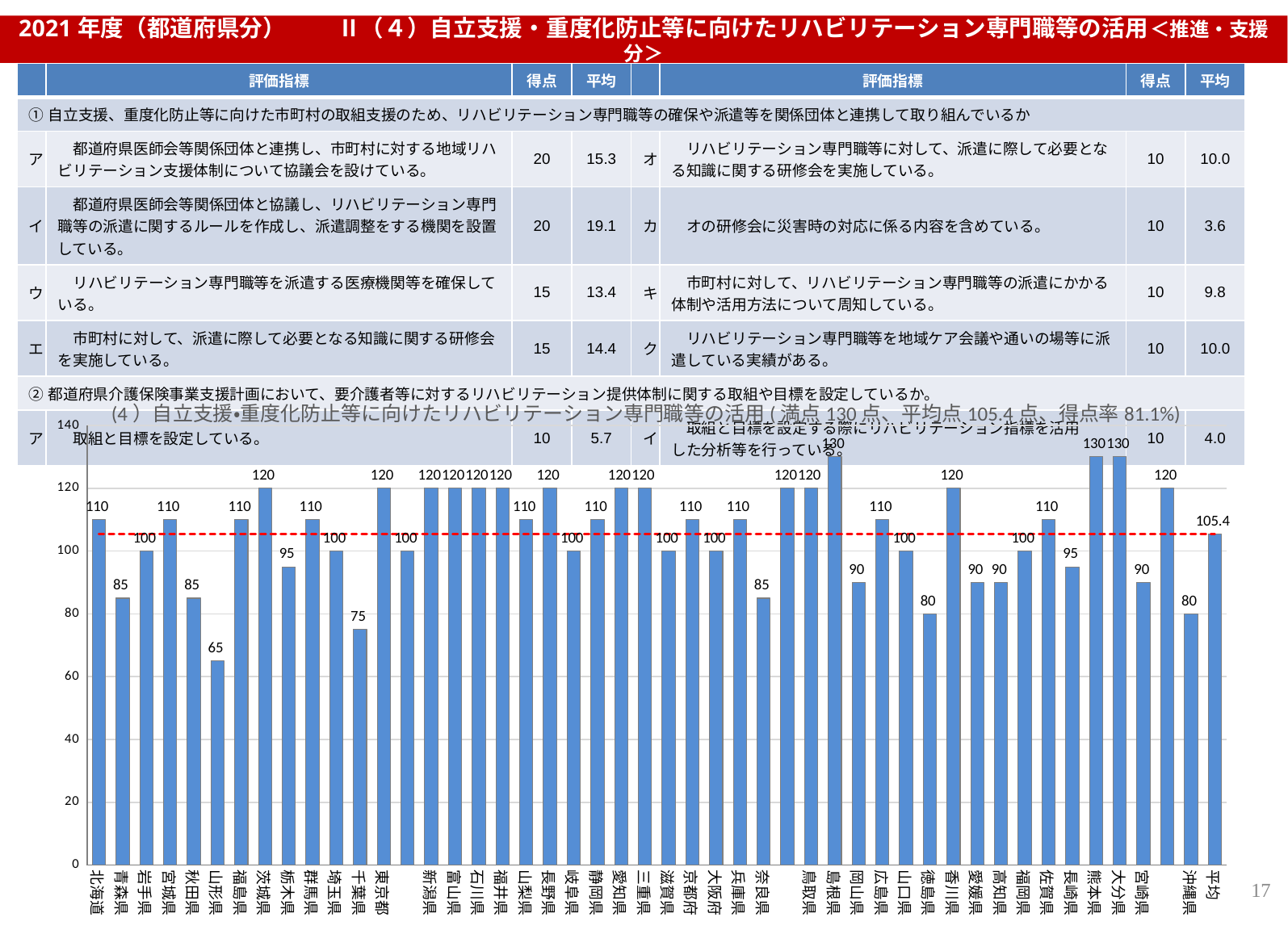
What is the value for 千葉県 in the bar chart? 75 According to the chart title, what is the 得点率 (score rate)? 81.1% What is the value for 熊本県 in the bar chart? 130 What is the difference between the values for 大分県 and 宮崎県? 40 Which has the larger value, 青森県 or 岩手県? 岩手県 What is the value shown for 平均 at the right end of the bar chart? 105.4 What is the value for 山形県 in the bar chart? 65 Which prefecture has the lowest value in the bar chart? 山形県 What is the value for 島根県 in the bar chart? 130 What is the difference between the values for 茨城県 and 栃木県? 25 What kind of chart is shown on the slide? combination bar and line chart (bars with a dashed average line) Is the value for 沖縄県 greater or less than 100? less